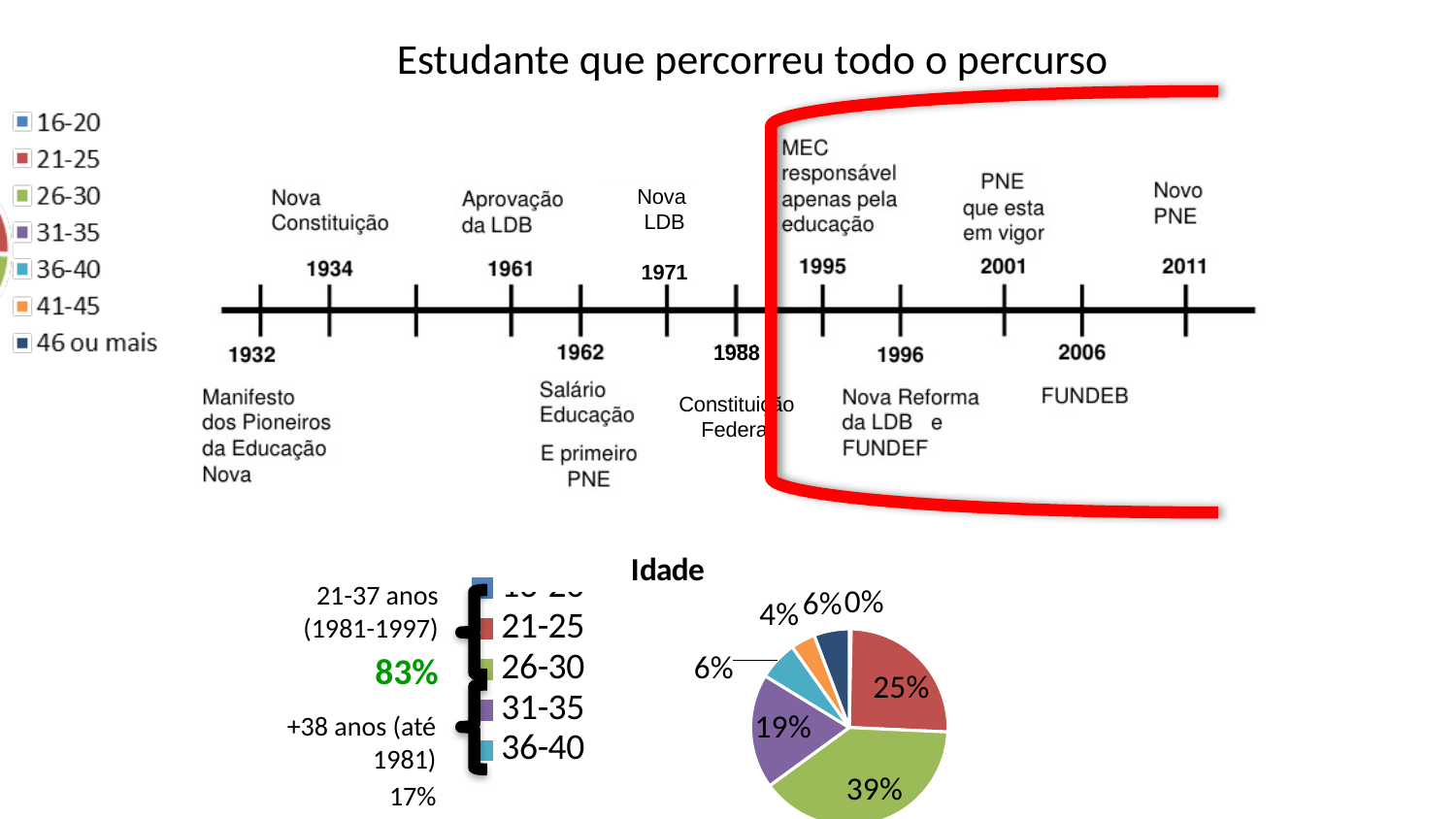
How many age groups does the legend of the Idade pie chart list? 7 In the Idade pie chart, what share does the 26-30 age group have? 39% Which age group has the largest slice in the Idade pie chart? 26-30 In the Idade pie chart, what share does the 41-45 age group have? 4% In the Idade pie chart, which is larger: the share for 31-35 or the share for 21-25? 21-25 In the Idade pie chart, what share does the 16-20 age group have? 0% What kind of chart is shown at the bottom of the slide? pie chart In the Idade pie chart, what share does the 31-35 age group have? 19% In the Idade pie chart, what is the difference between the shares of the 26-30 and 21-25 age groups? 14% In the Idade pie chart, what share does the 21-25 age group have? 25% Which age group has the smallest slice in the Idade pie chart? 16-20 What is the title of the pie chart on the slide? Idade